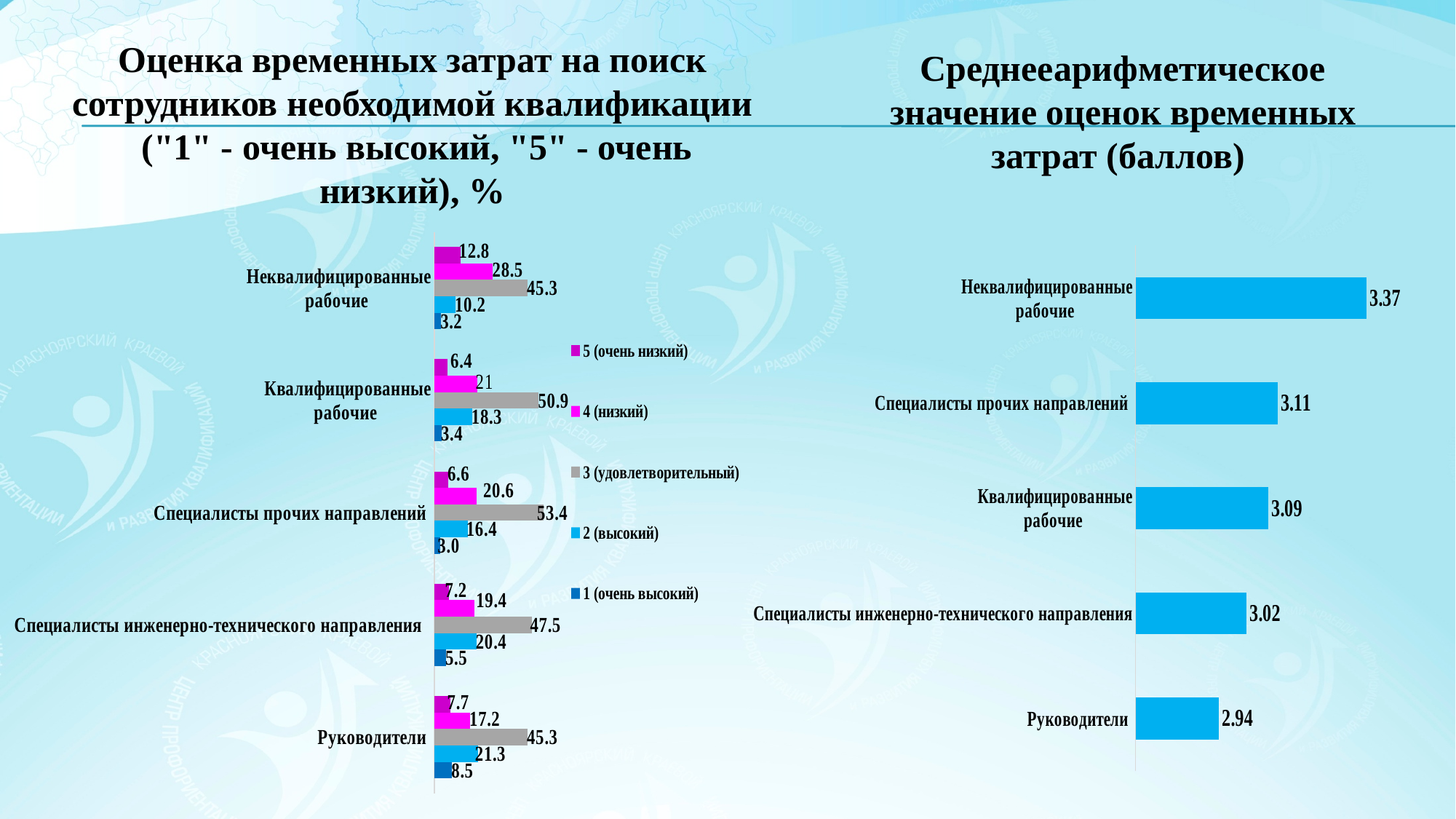
In the right chart, which category has the highest average score? Неквалифицированные рабочие In the left chart, which is larger for Квалифицированные рабочие: the '4 (низкий)' value or the '2 (высокий)' value? 4 (низкий) In the left chart, what is the value of the '1 (очень высокий)' series for Руководители? 8.5 In the right chart, what is the difference between the values for Неквалифицированные рабочие and Руководители? 0.43 In the left chart, how many series does the legend list? 5 In the left chart, what is the difference between the '3 (удовлетворительный)' values for Квалифицированные рабочие and Руководители? 5.6 In the right chart (Среднееарифметическое значение оценок временных затрат), what is the value for Руководители? 2.94 In the left chart, which colour represents the '5 (очень низкий)' series? Purple In the right chart, how many categories are shown? 5 In the left chart, what is the value of the '3 (удовлетворительный)' series for Специалисты прочих направлений? 53.4 What type of chart is the right chart? Bar chart In the right chart, which category has the lowest average score? Руководители